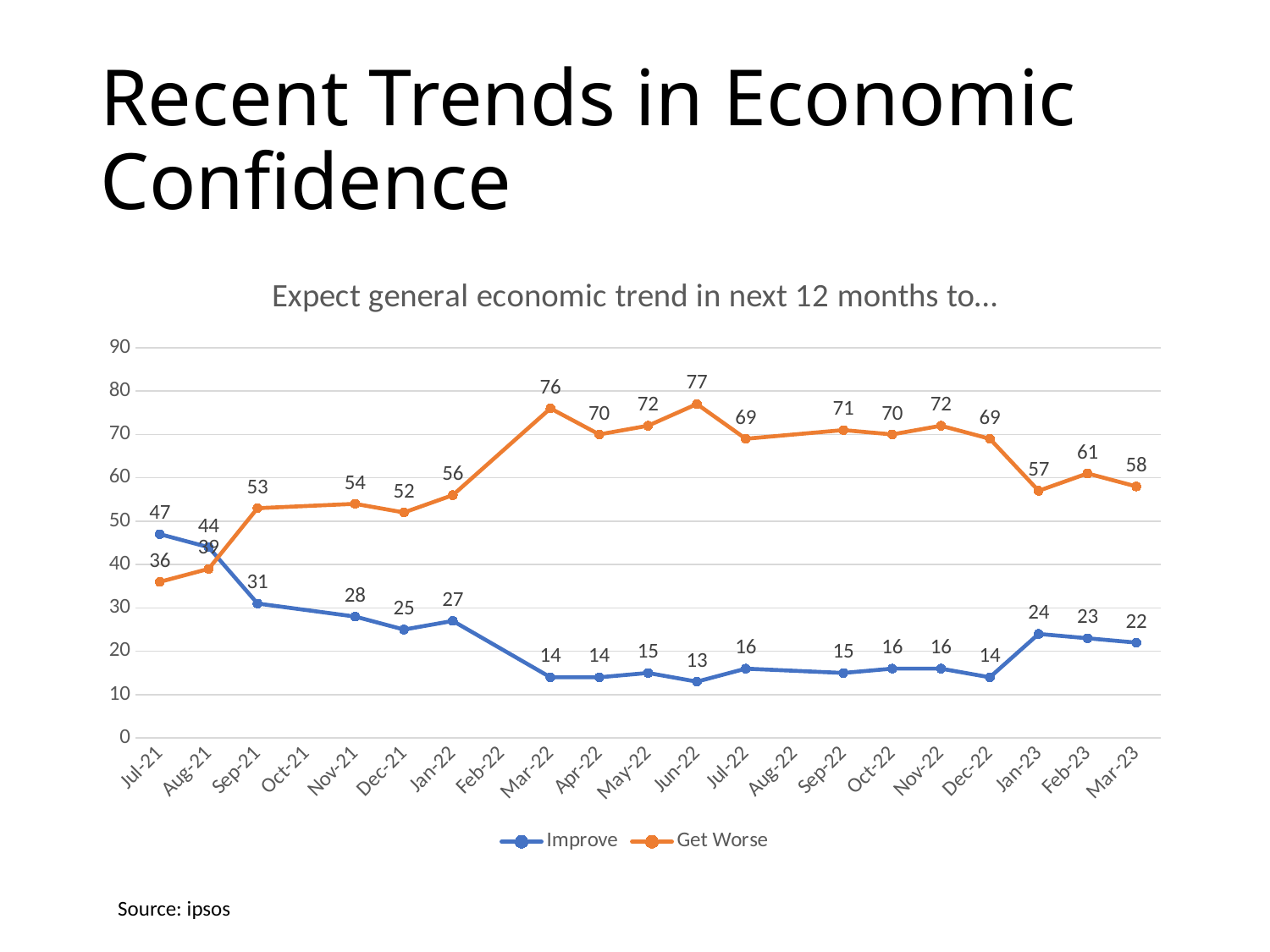
What is the value of the Get Worse series for Feb-23? 61 Does the Improve series rise or fall from Jul-21 to Mar-22? fall By how much did the Improve series increase from Dec-22 to Jan-23? 10 What is the value of the Improve series for Jul-21? 47 What is the value of the Get Worse series for Mar-22? 76 In which month does the Improve series reach its lowest value? Jun-22 How many series does the legend list? 2 What is the title of the chart? Expect general economic trend in next 12 months to... What kind of chart is shown on the slide? line chart For Jul-21, which series has the larger value, Improve or Get Worse? Improve In which month does the Get Worse series reach its highest value? Jun-22 What is the difference between the Get Worse and Improve values for Mar-23? 36